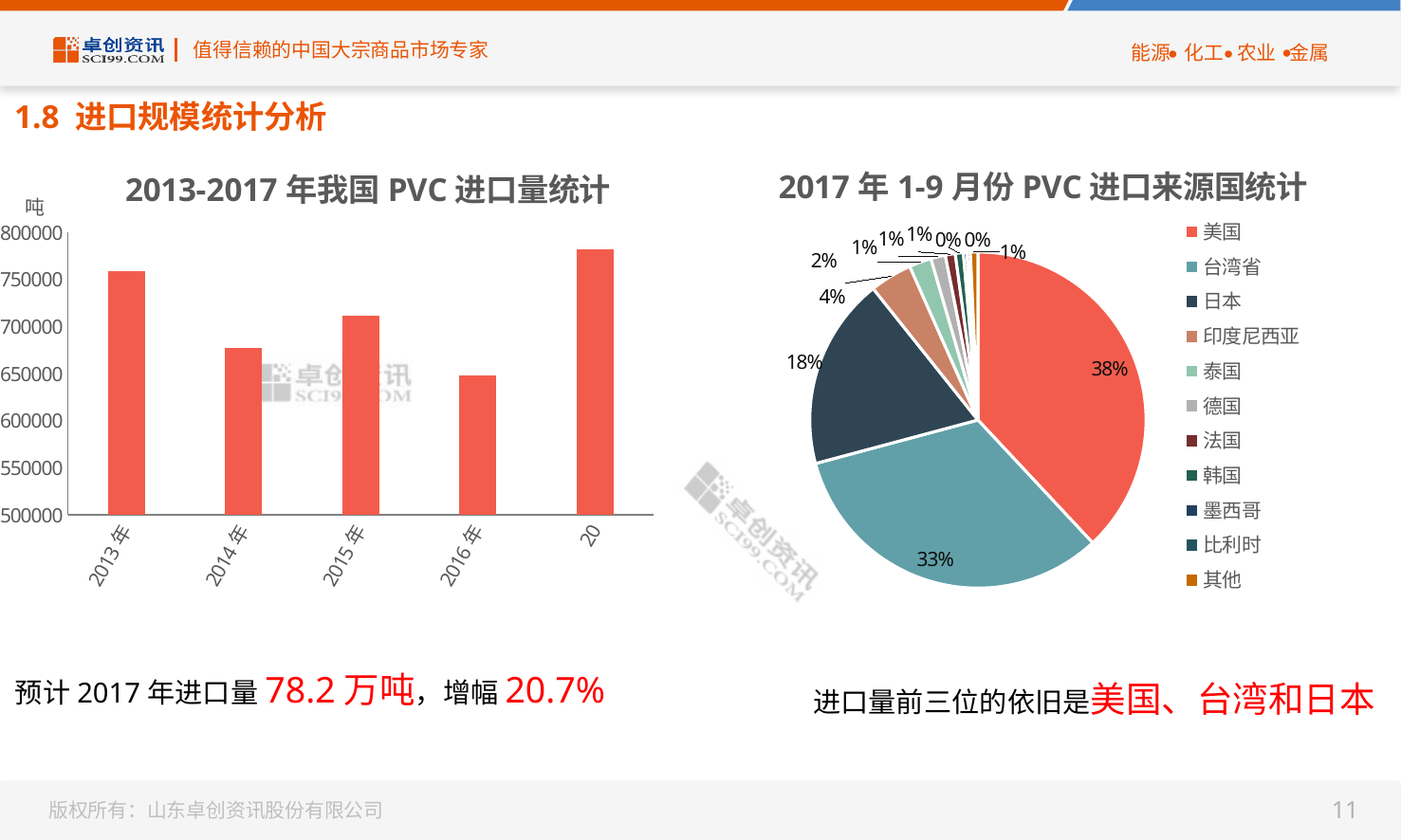
In the chart 2013-2017年我国PVC进口量统计, how many bars are plotted? 5 What kind of chart is the one titled 2013-2017年我国PVC进口量统计? bar chart In the chart 2013-2017年我国PVC进口量统计, which is larger, the value for 2013年 or 2014年? 2013年 In the chart 2017年1-9月份PVC进口来源国统计, how many percentage points larger is the share of 美国 than that of 台湾省? 5% What kind of chart is the one titled 2017年1-9月份PVC进口来源国统计? pie chart In the chart 2017年1-9月份PVC进口来源国统计, what share does 美国 have? 38% In the chart 2017年1-9月份PVC进口来源国统计, how many entries does the legend list? 11 In the chart 2013-2017年我国PVC进口量统计, which year has the lowest import volume? 2016年 In the chart 2017年1-9月份PVC进口来源国统计, what share does 日本 have? 18% In the chart 2017年1-9月份PVC进口来源国统计, what share does 台湾省 have? 33% In the chart 2013-2017年我国PVC进口量统计, is the value for 2014年 greater or less than 700000? less In the chart 2013-2017年我国PVC进口量统计, is the value for 2013年 greater or less than 750000? greater